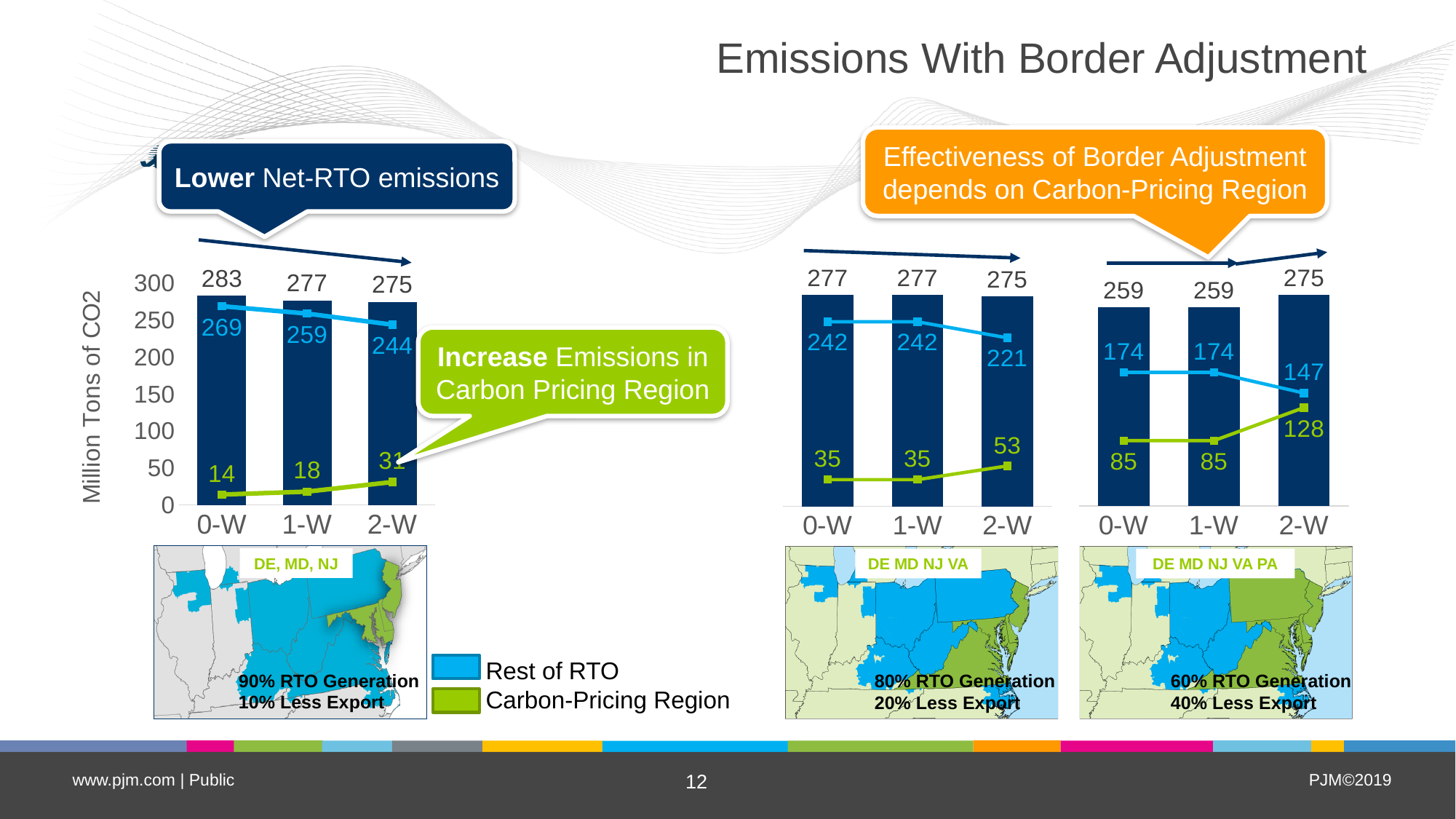
In the right chart (DE MD NJ VA PA), which is larger at 2-W: the Rest of RTO value or the Carbon-Pricing Region value? Rest of RTO In the left chart (DE, MD, NJ), what is the Rest of RTO value at 2-W? 244 In the middle chart (DE MD NJ VA), what is the Carbon-Pricing Region value at 2-W? 53 In the left chart (DE, MD, NJ), what is the total emissions value shown above the bar for 0-W? 283 In the right chart (DE MD NJ VA PA), which category has the highest bar total? 2-W In the left chart (DE, MD, NJ), does the Rest of RTO line rise or fall from 0-W to 2-W? fall How many categories are shown on the x axis of the left chart (DE, MD, NJ)? 3 In the left chart (DE, MD, NJ), which category has the lowest Carbon-Pricing Region value? 0-W In the right chart (DE MD NJ VA PA), what is the Rest of RTO value at 2-W? 147 In the left chart (DE, MD, NJ), what is the Carbon-Pricing Region value at 1-W? 18 How many series does the legend list? 2 In the middle chart (DE MD NJ VA), what is the difference between the Rest of RTO values at 0-W and 2-W? 21